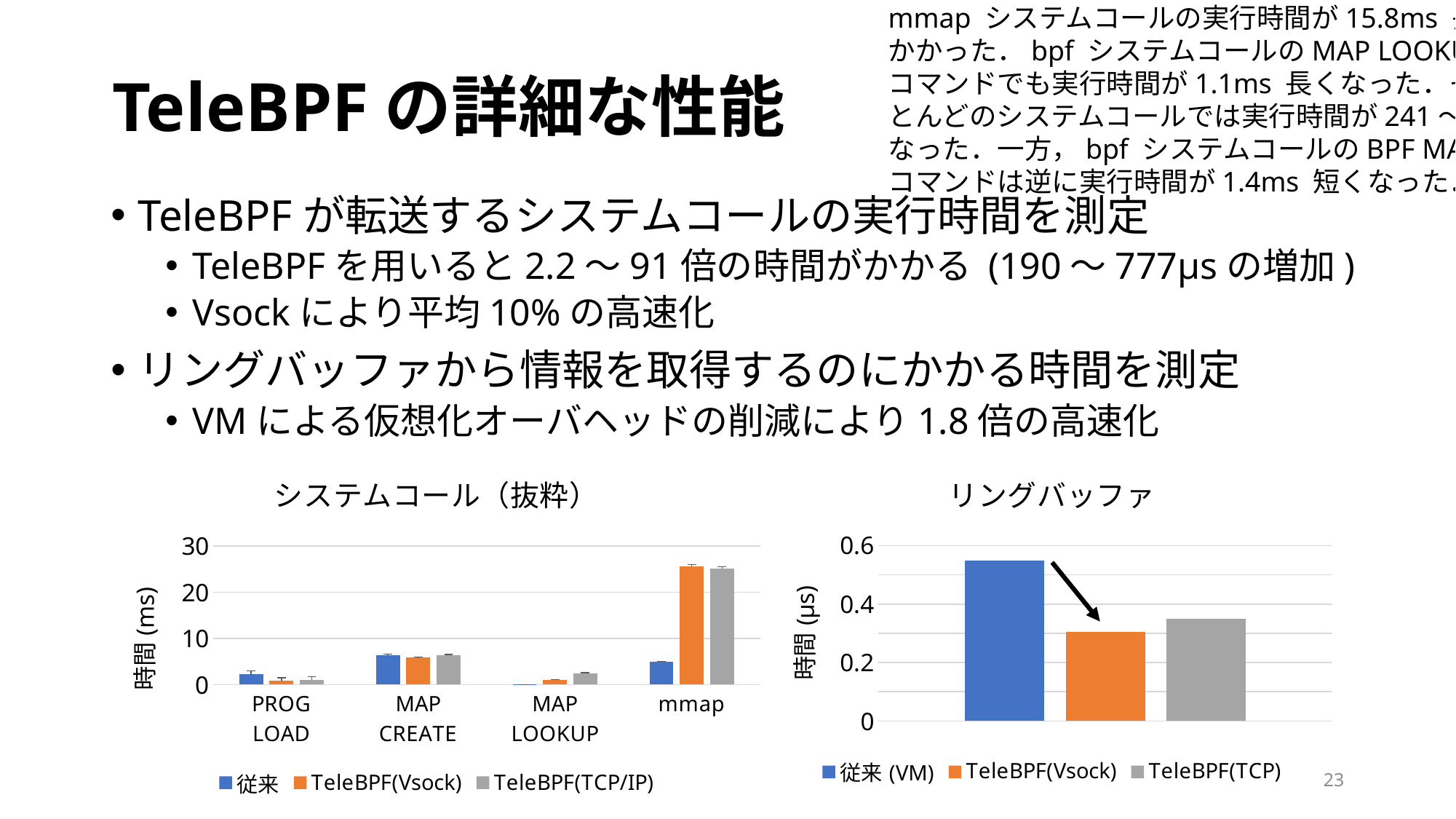
In the システムコール（抜粋） chart, is the value of TeleBPF(Vsock) for mmap greater or less than 20? greater In the システムコール（抜粋） chart, which category has the highest values? mmap In the リングバッファ chart, is the value for 従来 (VM) greater or less than 0.4? greater What kind of chart is the chart titled システムコール（抜粋）? bar chart In the システムコール（抜粋） chart, for MAP LOOKUP, which is larger: TeleBPF(TCP/IP) or 従来? TeleBPF(TCP/IP) How many categories are shown on the x axis of the システムコール（抜粋） chart? 4 How many series does the legend of the リングバッファ chart list? 3 In the システムコール（抜粋） chart, is the value of 従来 for mmap greater or less than 10? less In the リングバッファ chart, which series has the highest value? 従来 (VM) In the システムコール（抜粋） chart, for PROG LOAD, which is larger: 従来 or TeleBPF(Vsock)? 従来 What is the y-axis label of the システムコール（抜粋） chart? 時間 (ms) How many series does the legend of the システムコール（抜粋） chart list? 3